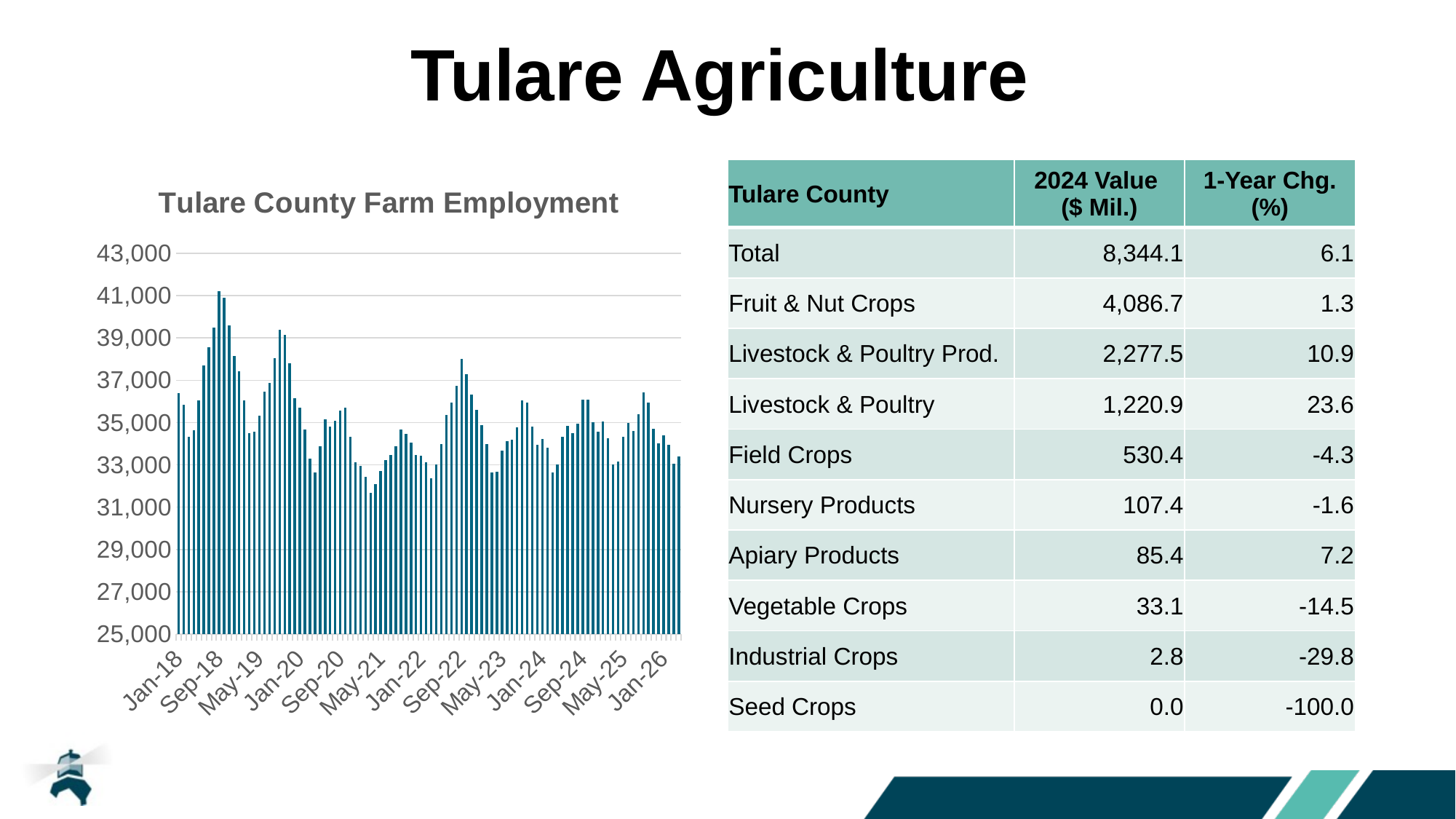
What kind of chart is the Tulare County Farm Employment chart? bar chart Is the value for Jan-18 in the Tulare County Farm Employment chart greater or less than 35,000? greater In which year does the Tulare County Farm Employment chart reach its highest value? 2018 What is the title of the chart on the slide? Tulare County Farm Employment What is the highest value shown on the y axis of the Tulare County Farm Employment chart? 43,000 Which is larger in the Tulare County Farm Employment chart, the value for Jan-18 or the value for Jan-26? Jan-18 Does farm employment rise or fall between Sep-18 and May-19 in the Tulare County Farm Employment chart? fall Does farm employment rise or fall between Jan-18 and Sep-18 in the Tulare County Farm Employment chart? rise Is the value for Jan-20 in the Tulare County Farm Employment chart greater or less than 37,000? less Is the lowest bar in the Tulare County Farm Employment chart greater or less than 31,000? greater